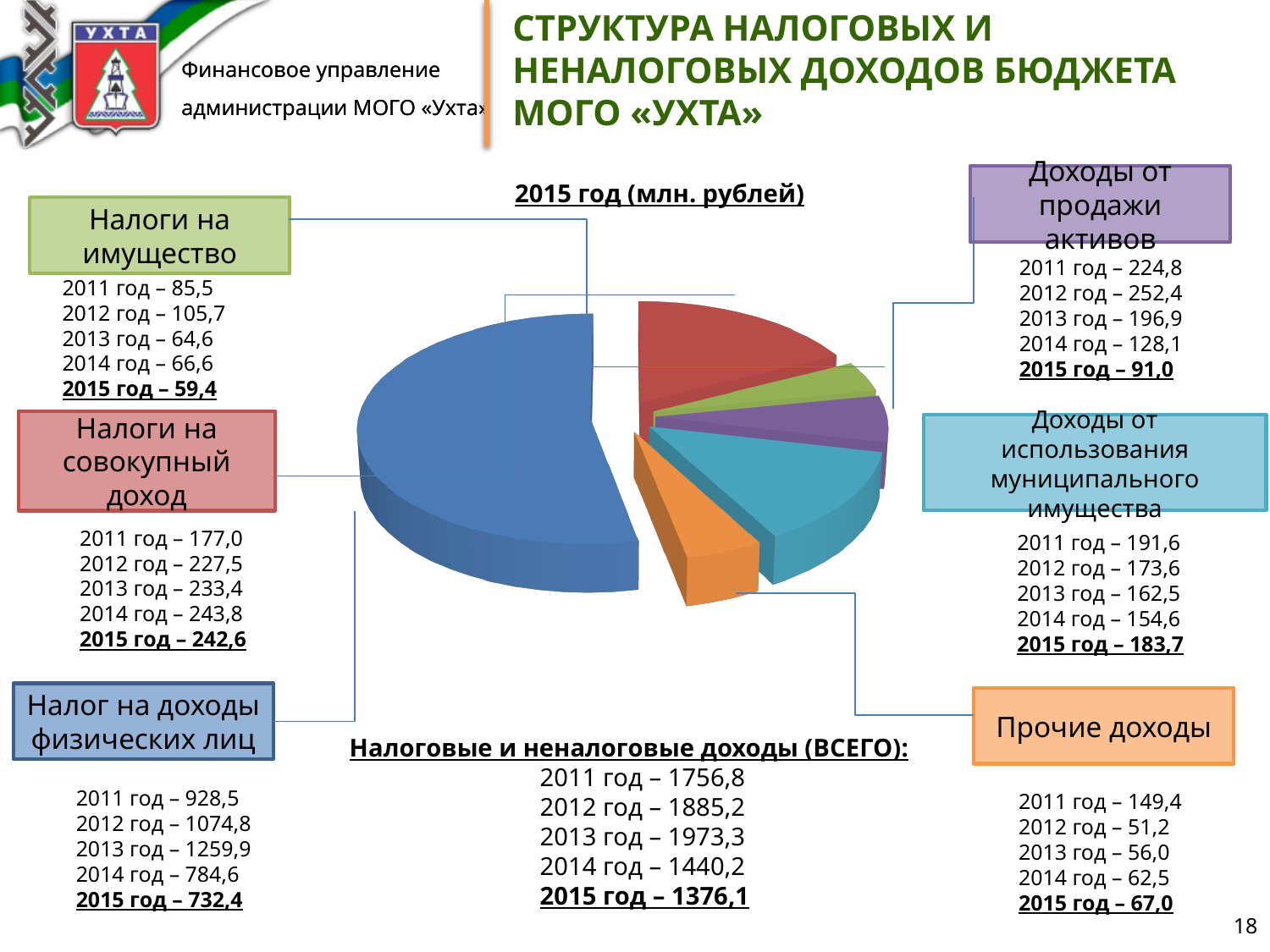
How many slices does the pie chart have? 6 Which is larger in 2015: Доходы от использования муниципального имущества or Прочие доходы? Доходы от использования муниципального имущества What is the 2015 value for Налоги на имущество? 59,4 What kind of chart is shown on the slide? Pie chart Which category has the largest slice in the 2015 pie chart? Налог на доходы физических лиц What is the 2015 value for Налог на доходы физических лиц? 732,4 What year and unit does the pie chart's title state? 2015 год (млн. рублей) What is the total of Налоговые и неналоговые доходы for 2015? 1376,1 What is the difference between the 2015 values for Налоги на совокупный доход and Доходы от продажи активов? 151,6 What is the 2015 value for Прочие доходы? 67,0 Which category has the smallest slice in the 2015 pie chart? Налоги на имущество What is the 2015 value for Доходы от использования муниципального имущества? 183,7